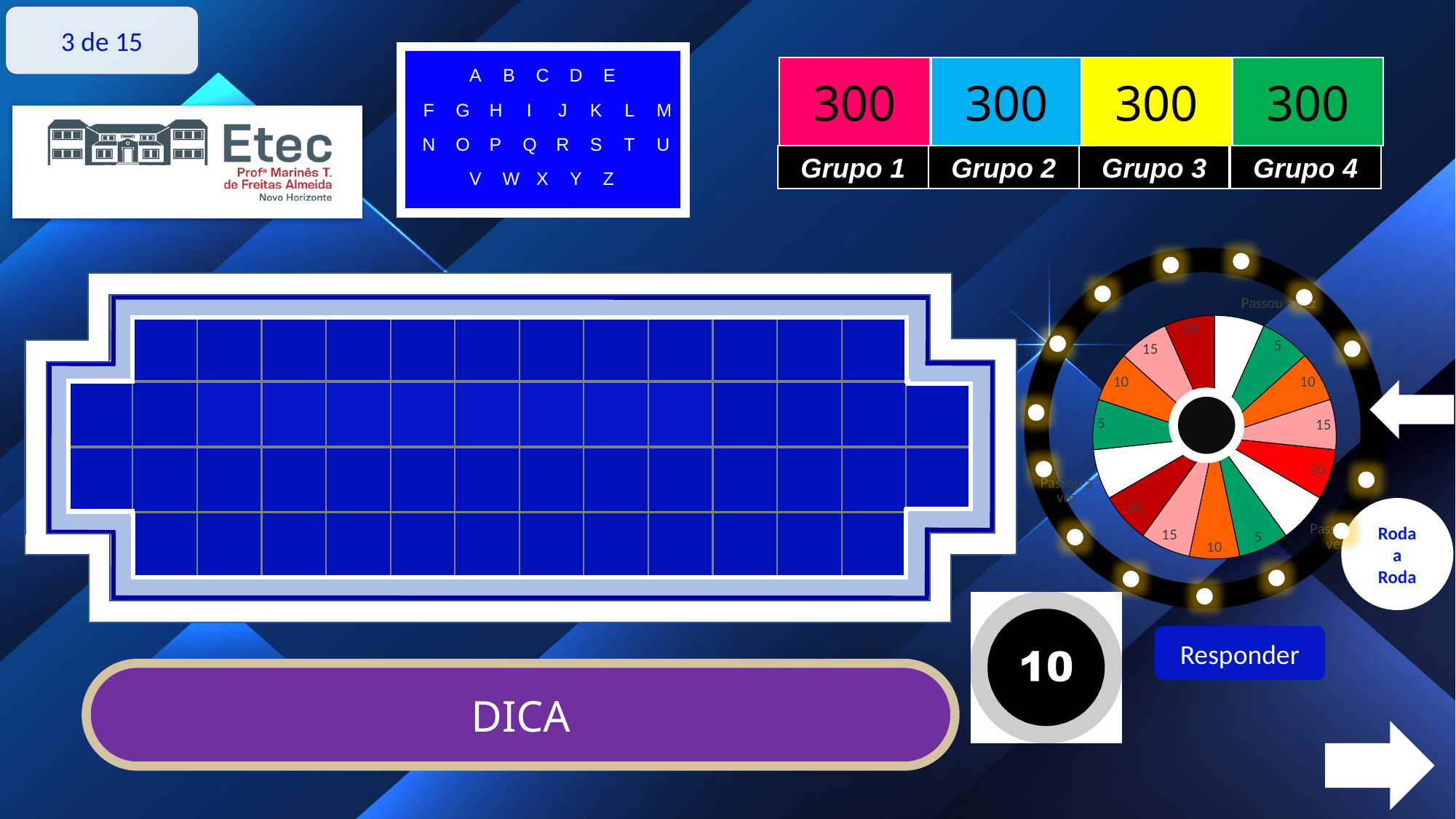
What is the difference between the largest and smallest numbers printed on the wheel segments? 15 What is the largest number printed on any segment of the wheel? 20 What kind of chart is the wheel on the right side of the slide? pie chart Which is larger, the value on the pink segments or the value on the orange segments of the wheel? pink (15) What colour are the wheel segments labelled 20? red What is the smallest number printed on any segment of the wheel? 5 What colour are the wheel segments labelled 5? green